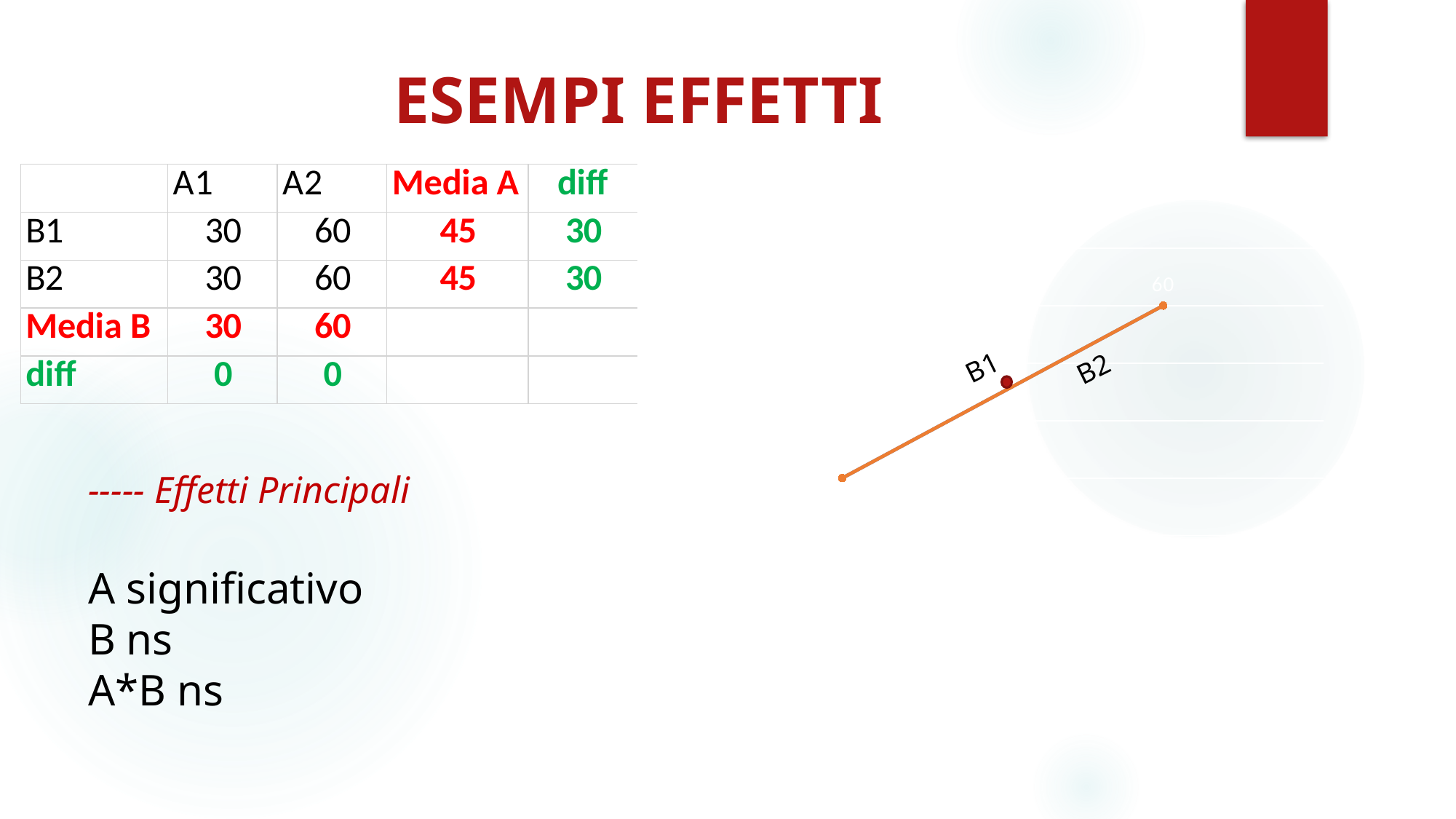
How many data points are plotted along the line in the chart? 2 Does the line in the chart rise or fall from left to right? rise What value is printed as the data label at the right end of the line in the chart? 60 In the chart, is the right-hand point higher or lower than the left-hand point? higher What colour is the line plotted in the chart? orange Which two series labels appear next to the line in the chart? B1 and B2 What kind of chart is shown on the right of the slide? line chart